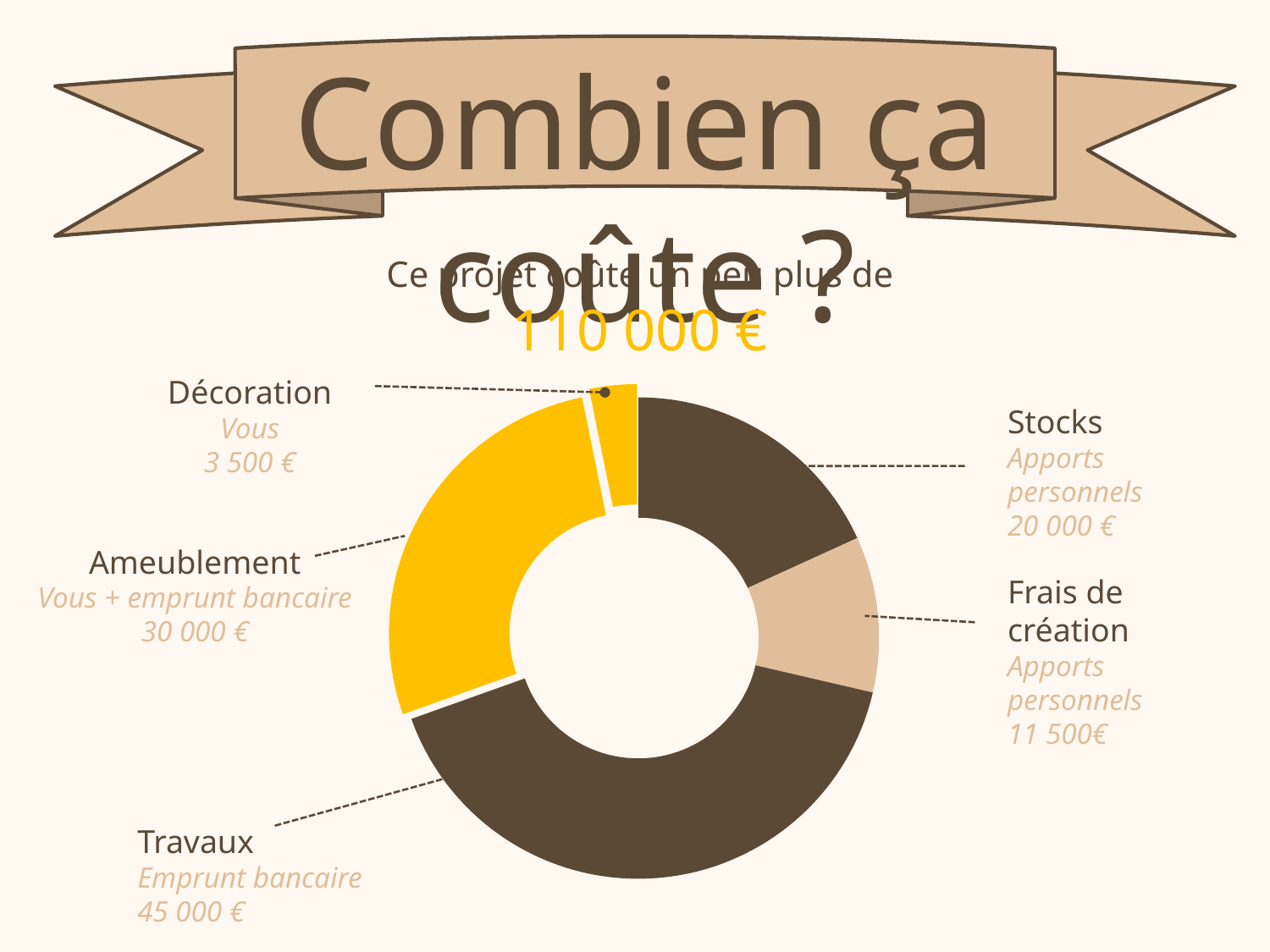
What is the value for Stocks? 20 000 € According to the slide, what is the total cost of the project? 110 000 € Which category has the lowest value? Décoration Which is larger, Stocks or Frais de création? Stocks What kind of chart is shown on the slide? doughnut chart What is the value for Ameublement? 30 000 € What is the value for Travaux? 45 000 € Which category has the highest value? Travaux How many categories does the chart show? 5 What is the value for Frais de création? 11 500€ What is the value for Décoration? 3 500 € What is the difference between Travaux and Ameublement? 15 000 €